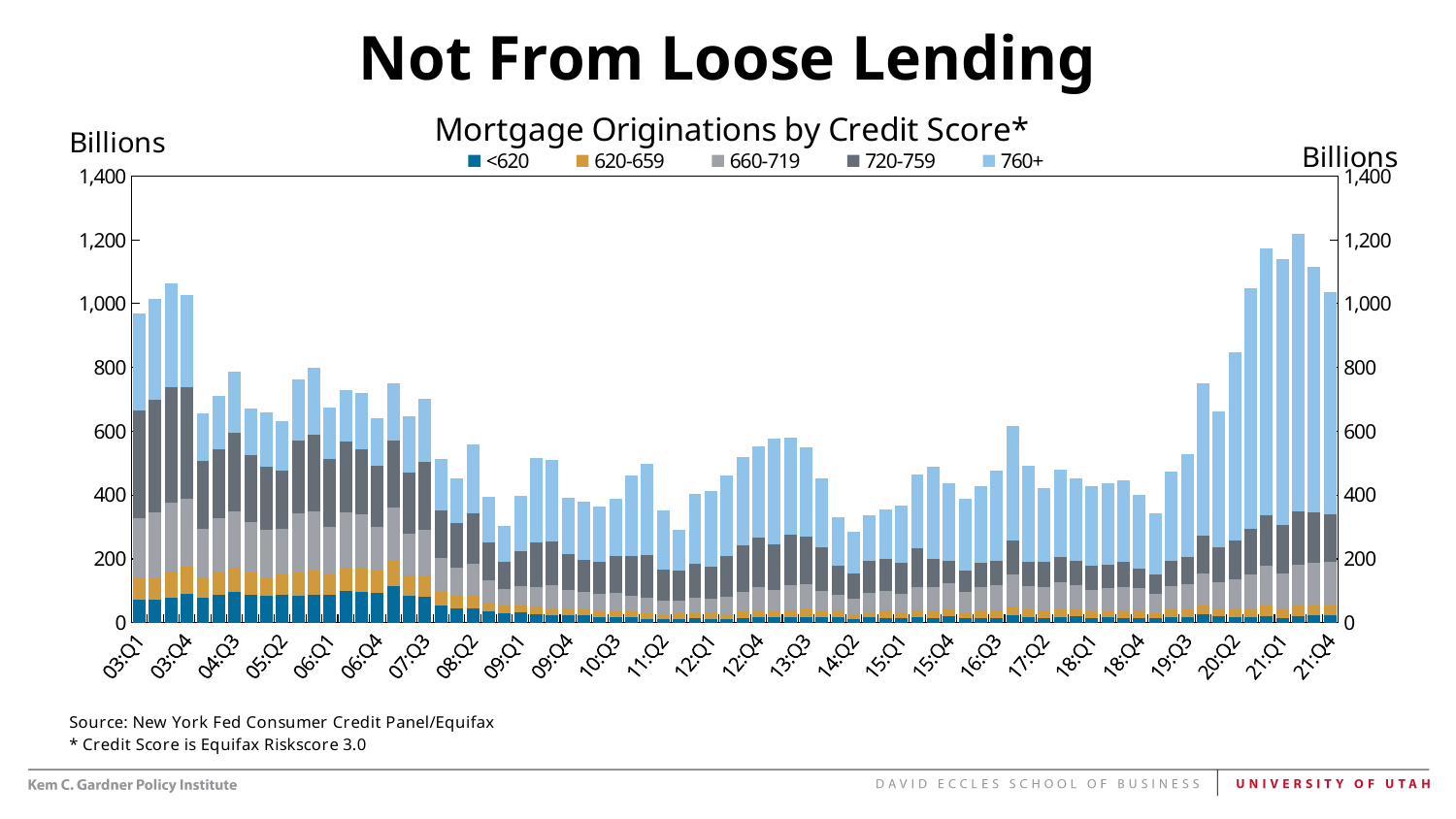
Is the total value for 03:Q1 greater or less than 800? greater Is the total value for 21:Q1 greater or less than 1,000? greater Is the total value for 14:Q2 greater or less than 400? less How many series does the legend list? 5 What is the title of the chart? Mortgage Originations by Credit Score* Which quarter has the highest total mortgage originations? 21:Q2 Do total mortgage originations rise or fall from 19:Q3 to 21:Q1? rise What kind of chart is shown on the slide? Stacked bar chart What are the credit score ranges listed in the legend? <620, 620-659, 660-719, 720-759, 760+ Which quarter has a larger total, 06:Q1 or 11:Q2? 06:Q1